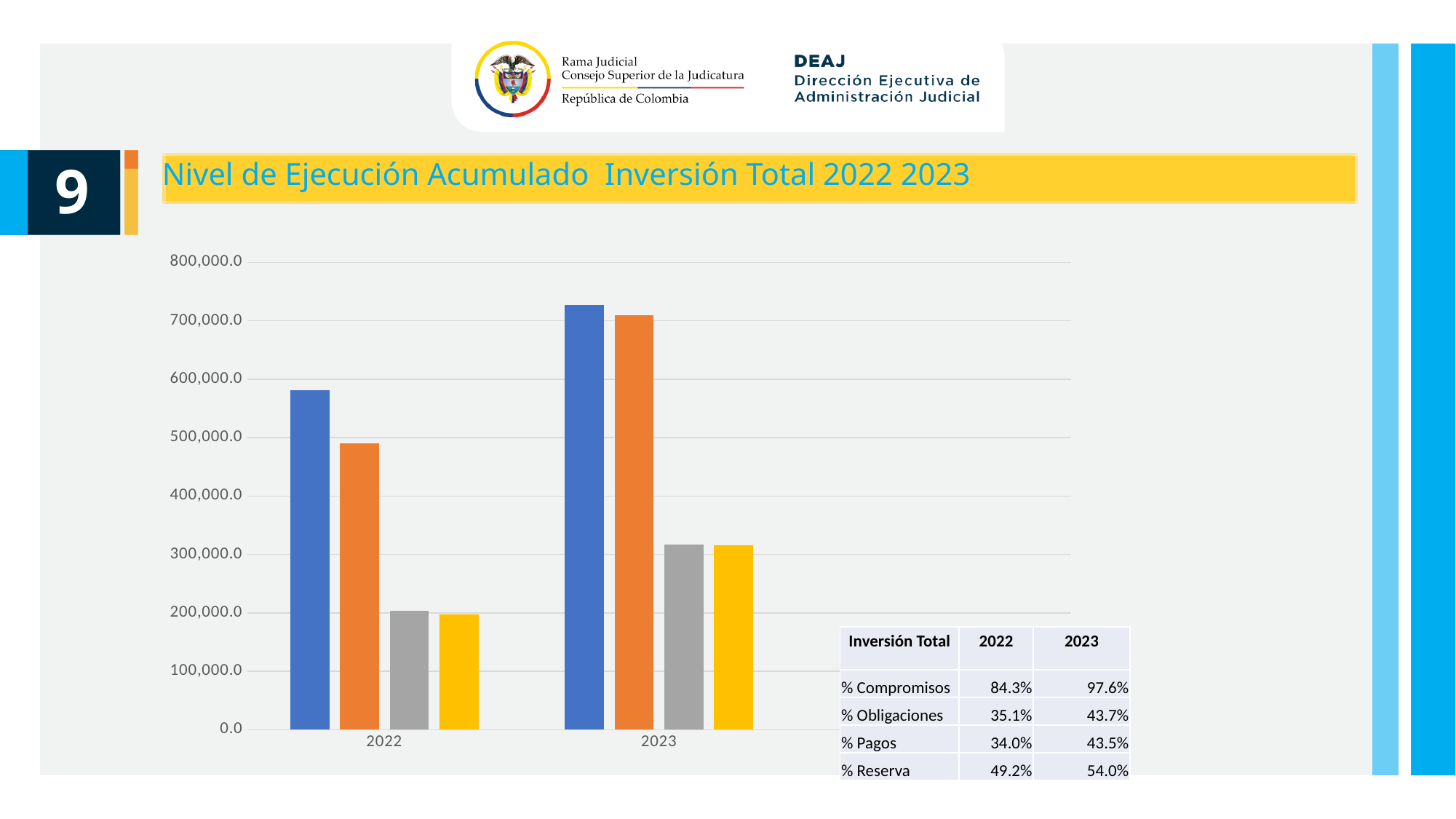
Is the value of the orange bar for 2022 greater or less than 600,000.0? less Do the bar values rise or fall from 2022 to 2023? rise Is the value of the gray bar for 2023 greater or less than 300,000.0? greater Is the value of the blue bar for 2023 greater or less than 700,000.0? greater Which year has the taller blue bar, 2022 or 2023? 2023 How many bars are plotted for each year in the chart? 4 Which bar in the chart is the tallest overall? the blue bar for 2023 What is the title of the slide above the chart? Nivel de Ejecución Acumulado Inversión Total 2022 2023 How many year categories are shown on the x axis of the chart? 2 What kind of chart is shown on the slide? bar chart